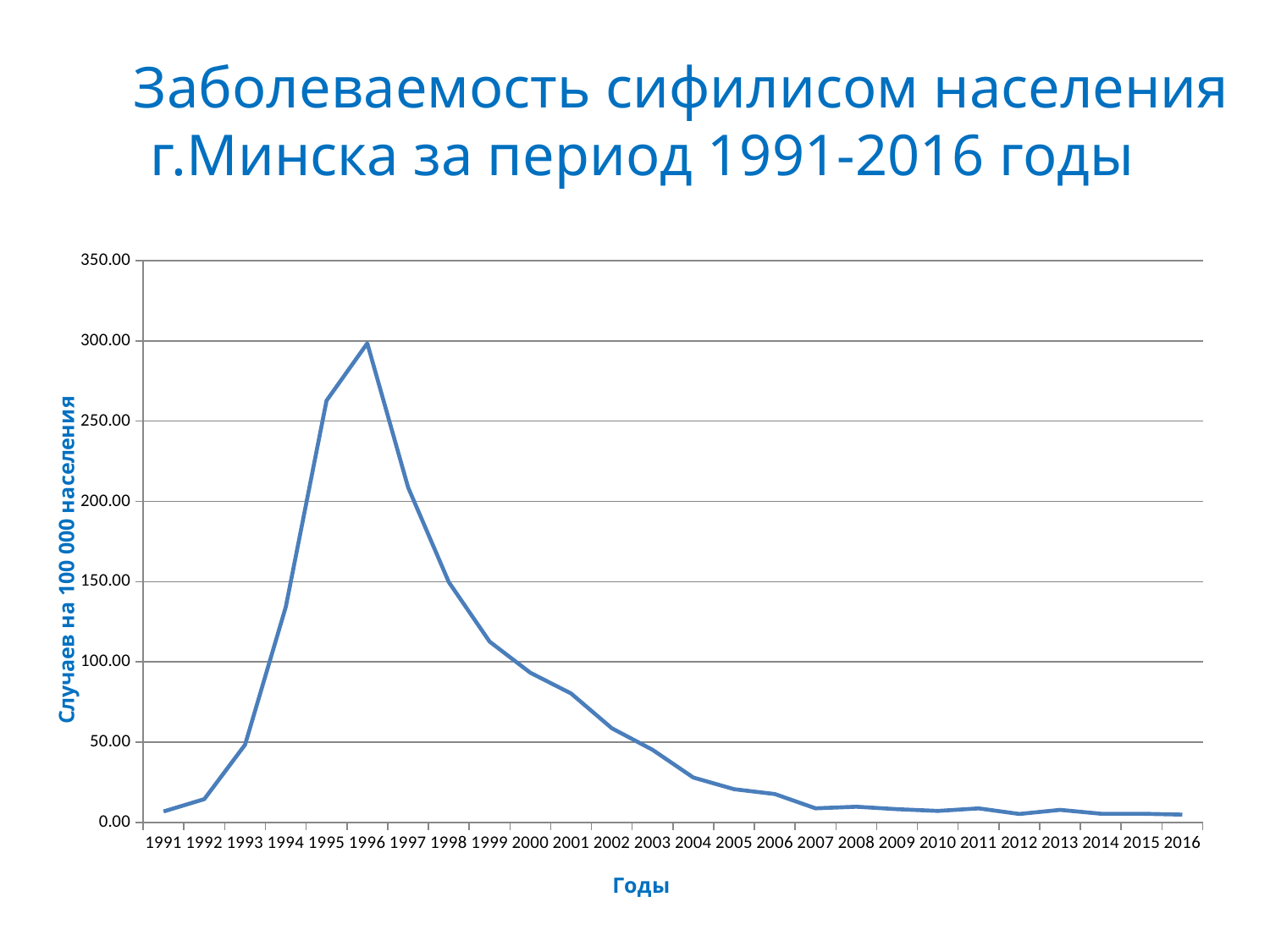
Do the values rise or fall from 1996 to 2016? fall Which year has the highest syphilis incidence on the chart? 1996 What is the label of the vertical axis? Случаев на 100 000 населения Is the value for 2004 greater or less than 50? less Which year has the larger value, 1995 or 1997? 1995 Is the value for 1996 greater or less than 250? greater Do the values rise or fall from 1991 to 1996? rise What kind of chart is shown on the slide? line chart Is the value for 2001 greater or less than 100? less How many years are plotted along the x axis? 26